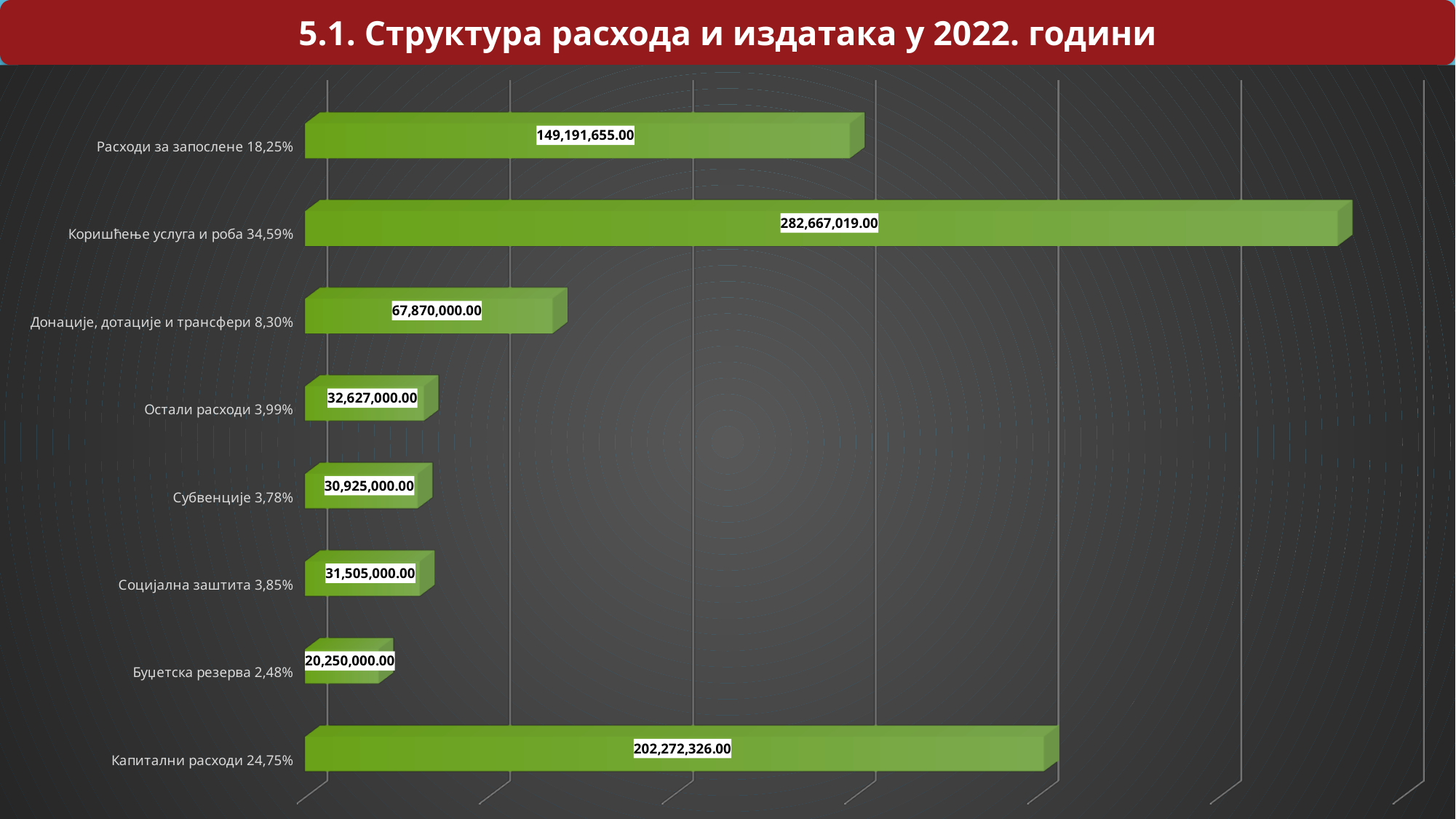
What is the value shown for Капитални расходи? 202,272,326.00 What is the value shown for Донације, дотације и трансфери? 67,870,000.00 Which category has the lowest value? Буџетска резерва Which category has the highest value? Коришћење услуга и роба What is the value shown for Коришћење услуга и роба? 282,667,019.00 Which is larger, the value for Социјална заштита or the value for Субвенције? Социјална заштита What percentage share is shown in the label for Расходи за запослене? 18,25% How many categories are shown in the chart? 8 What is the difference between the values for Донације, дотације и трансфери and Остали расходи? 35,243,000.00 What is the difference between the values for Коришћење услуга и роба and Капитални расходи? 80,394,693.00 What kind of chart is shown on the slide? Bar chart What is the value shown for Буџетска резерва? 20,250,000.00